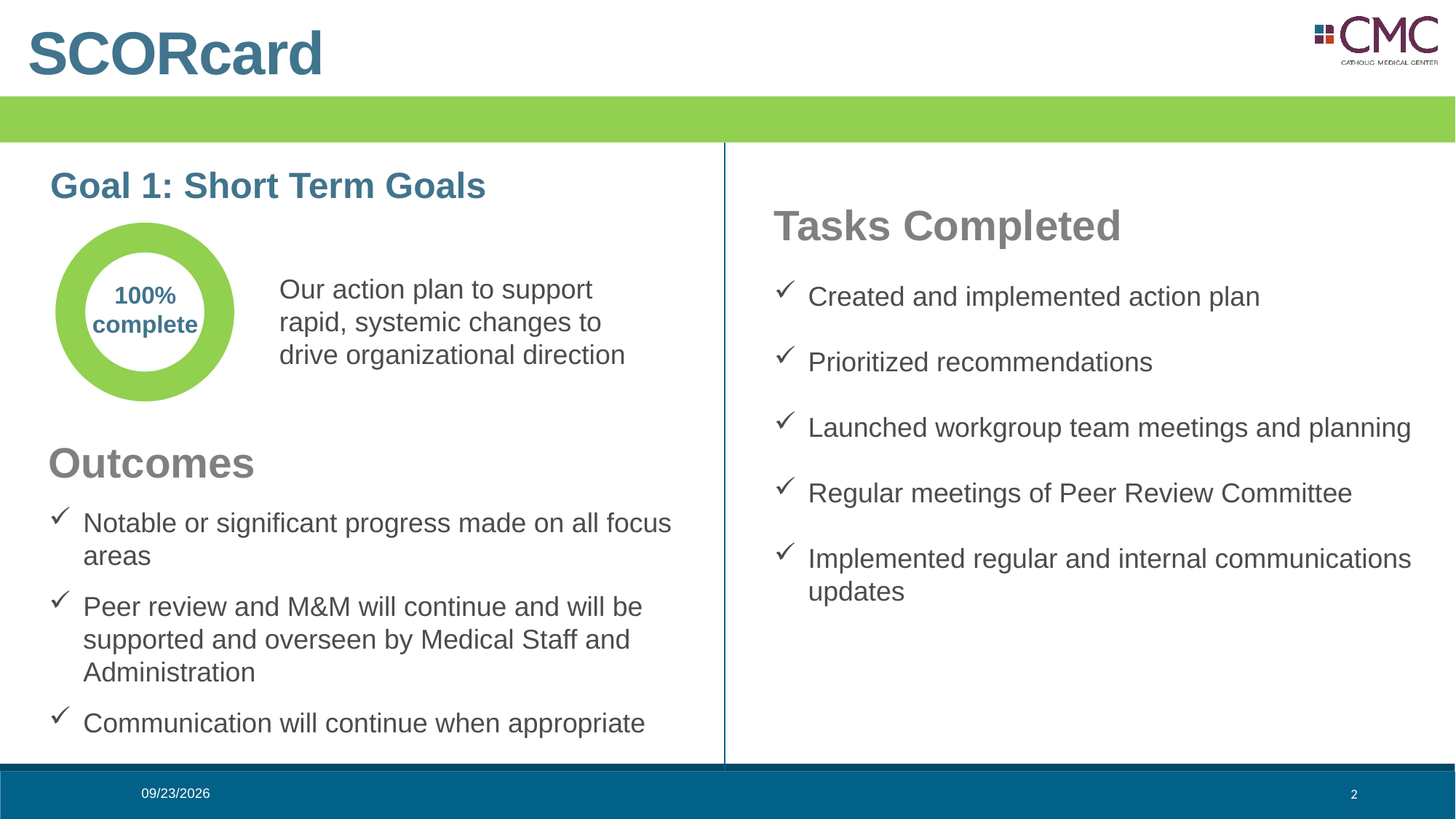
What share of the doughnut chart does the completed portion occupy? 100% How many distinct slices are visible in the doughnut chart? 1 What colour is the ring of the doughnut chart? green What percentage complete does the doughnut chart under "Goal 1: Short Term Goals" show? 100% Is the completion value shown in the doughnut chart greater or less than 50%? greater What text is printed in the centre of the doughnut chart? 100% complete Which goal does the doughnut chart relate to? Goal 1: Short Term Goals What kind of chart is shown under "Goal 1: Short Term Goals"? doughnut chart